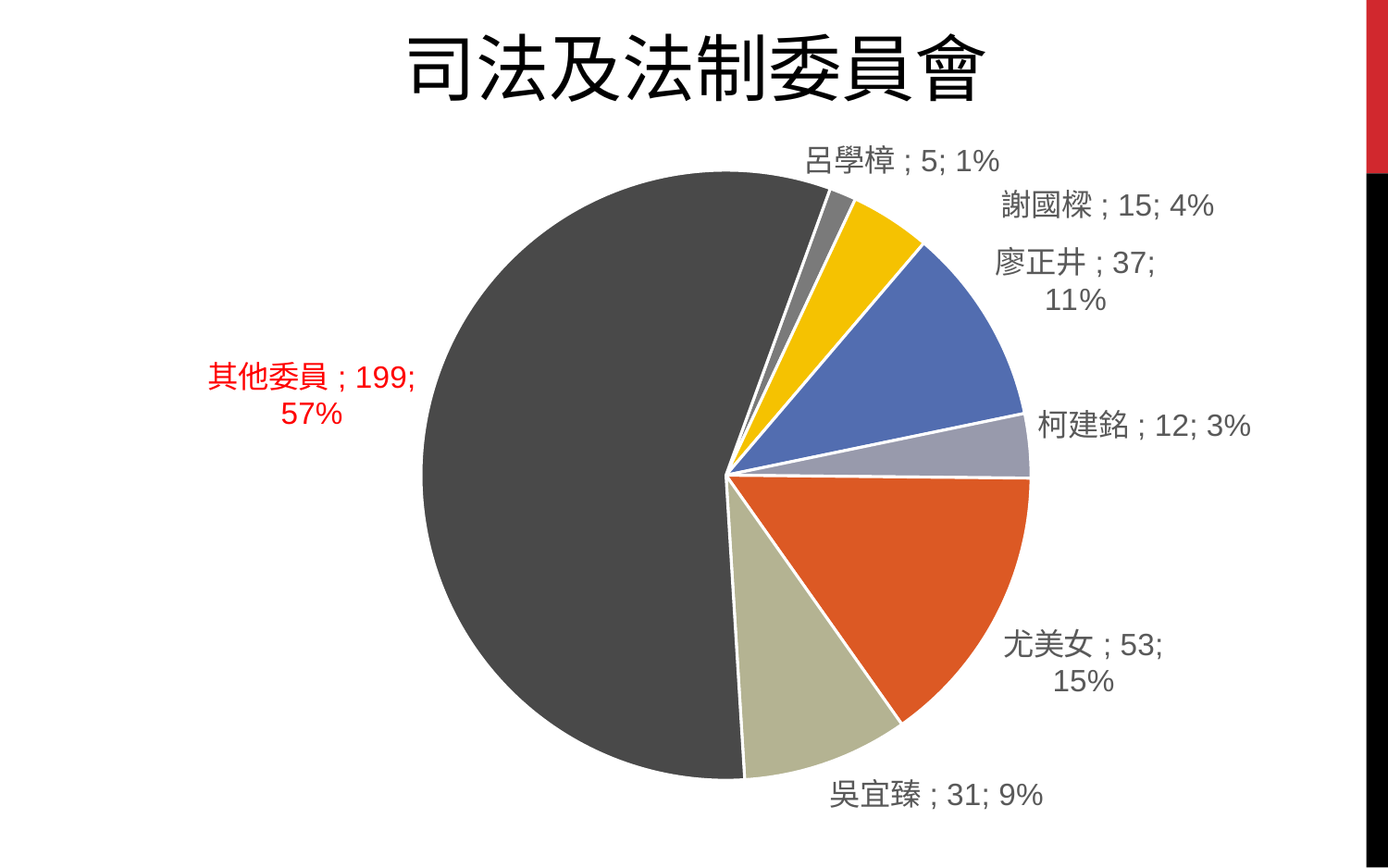
What is the value for 廖正井? 37 What is the title of the chart? 司法及法制委員會 How many slices does the pie chart have? 7 What percentage share does 吳宜臻 have? 9% What is the difference between the values for 尤美女 and 柯建銘? 41 Which category has the largest slice? 其他委員 What is the value for 尤美女? 53 What percentage share does 其他委員 have? 57% What is the value for 柯建銘? 12 Which category has the smallest slice? 呂學樟 What type of chart is shown on the slide? pie chart Which is larger, the value for 謝國樑 or the value for 吳宜臻? 吳宜臻